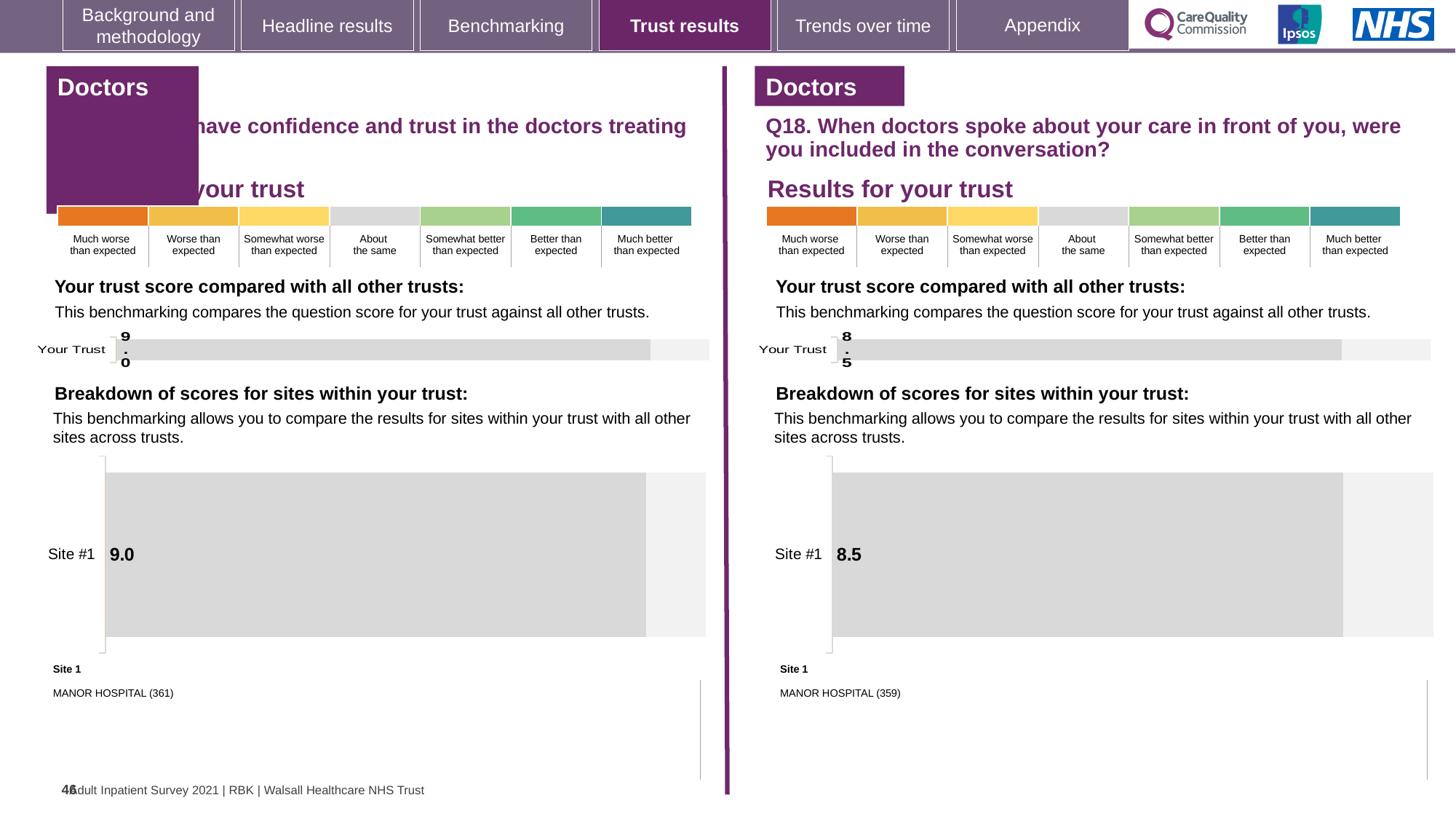
For Q18 on the right half of the slide, what score is shown for Site #1 in the breakdown chart? 8.5 For Q18 on the right half of the slide, what is the value shown for Your Trust in the trust score chart? 8.5 What kind of chart is used to show the Site #1 score in the Q18 breakdown chart on the right? Bar chart What is the difference between the Site #1 score in the left breakdown chart and the Site #1 score in the Q18 breakdown chart on the right? 0.5 Which is larger: the Site #1 score in the left breakdown chart or the Site #1 score in the Q18 breakdown chart on the right? The left chart (9.0) How many sites are plotted in the 'Breakdown of scores for sites within your trust' chart on the left half of the slide? 1 According to the key below the Q18 breakdown chart on the right, which hospital is Site 1? MANOR HOSPITAL (359) On the left half of the slide, what is the value shown for Your Trust in the 'Your trust score compared with all other trusts' chart? 9.0 In the Q18 trust score chart on the right, what is the label of the single bar? Your Trust On the left half of the slide, what score is shown for Site #1 in the 'Breakdown of scores for sites within your trust' chart? 9.0 How many sites are plotted in the Q18 'Breakdown of scores for sites within your trust' chart on the right half of the slide? 1